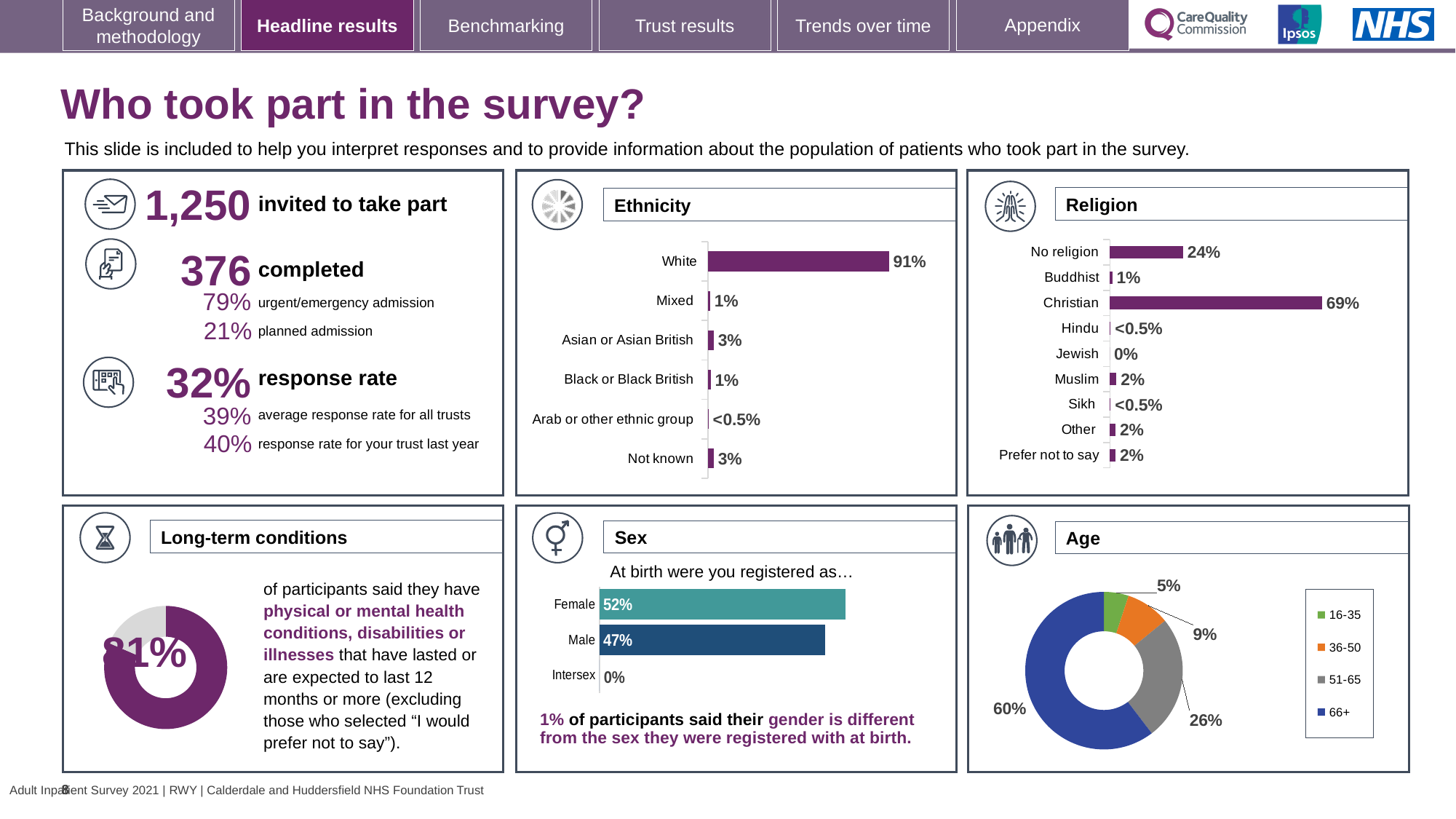
In the Ethnicity chart, what is the difference between the White and Asian or Asian British percentages? 88% In the Religion chart, what percentage of participants were Christian? 69% In the Religion chart, which is larger, Christian or No religion? Christian In the Ethnicity chart, how many ethnic categories are plotted? 6 In the Ethnicity chart, what percentage of participants were White? 91% In the Sex chart, what is the difference between the Female and Male percentages? 5% In the Age chart, how many age groups does the legend list? 4 In the Religion chart, how many religion categories are listed? 9 In the Ethnicity chart, which category has the highest value? White In the Religion chart, what is the value for No religion? 24% In the Sex chart, what percentage of participants were registered as Female at birth? 52% In the Age chart, what share of participants were aged 66+? 60%